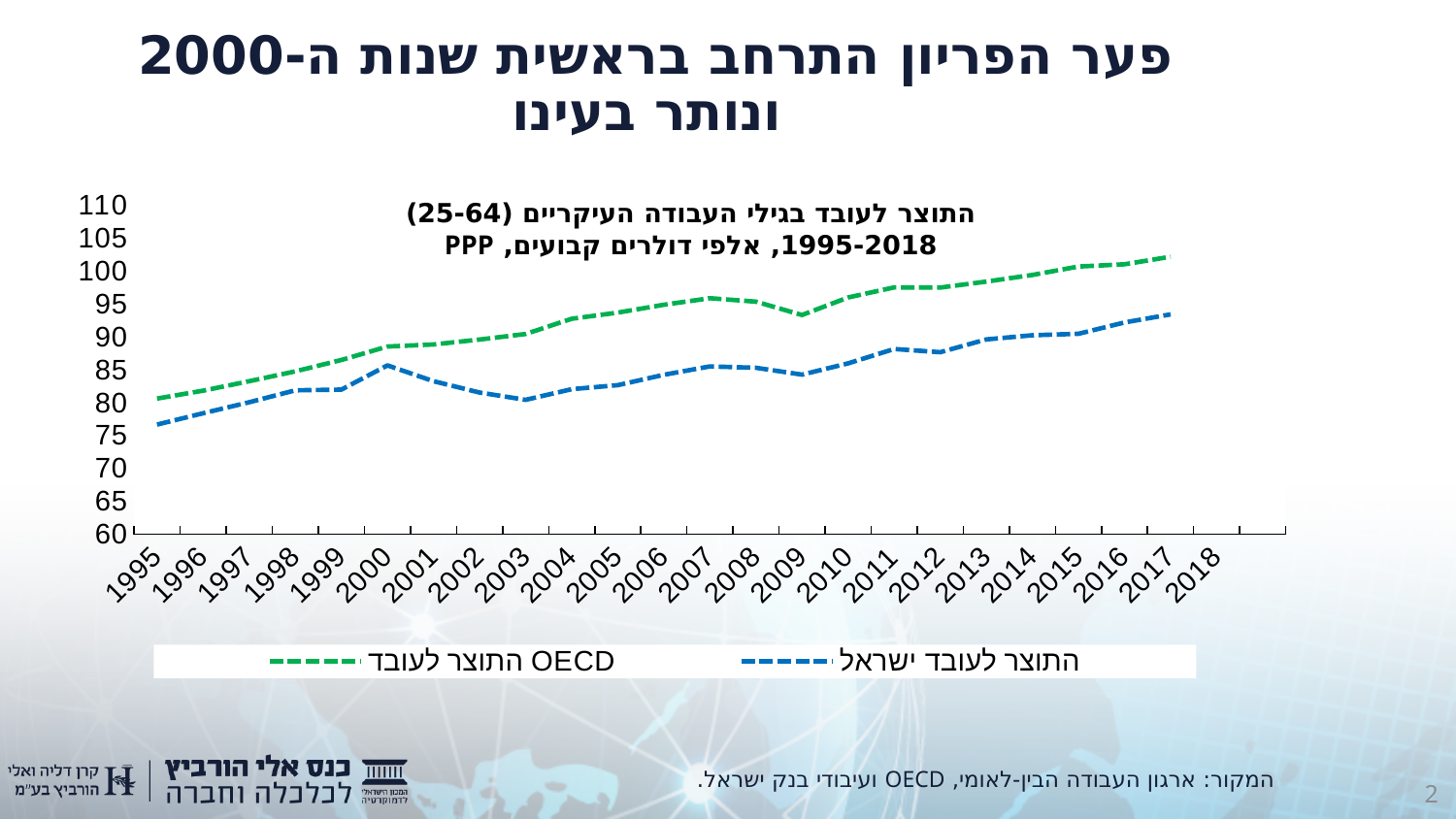
Is the value for OECD output per worker in 2017 greater or less than 100? greater Is the value for OECD output per worker in 2009 greater or less than 90? greater Is the value for Israel output per worker in 2017 greater or less than 90? greater In 2010, which is larger: the OECD output per worker or the Israel output per worker? OECD output per worker Which series is shown with the green dashed line? OECD התוצר לעובד Does the Israel output per worker (blue line) rise or fall between 2000 and 2003? Fall In which year is the Israel output per worker (blue line) at its lowest? 1995 How many years are labelled on the x axis? 24 How many series does the legend list? 2 What kind of chart is shown on the slide? Line chart Does the OECD output per worker (green line) rise or fall overall from 1995 to 2017? Rise